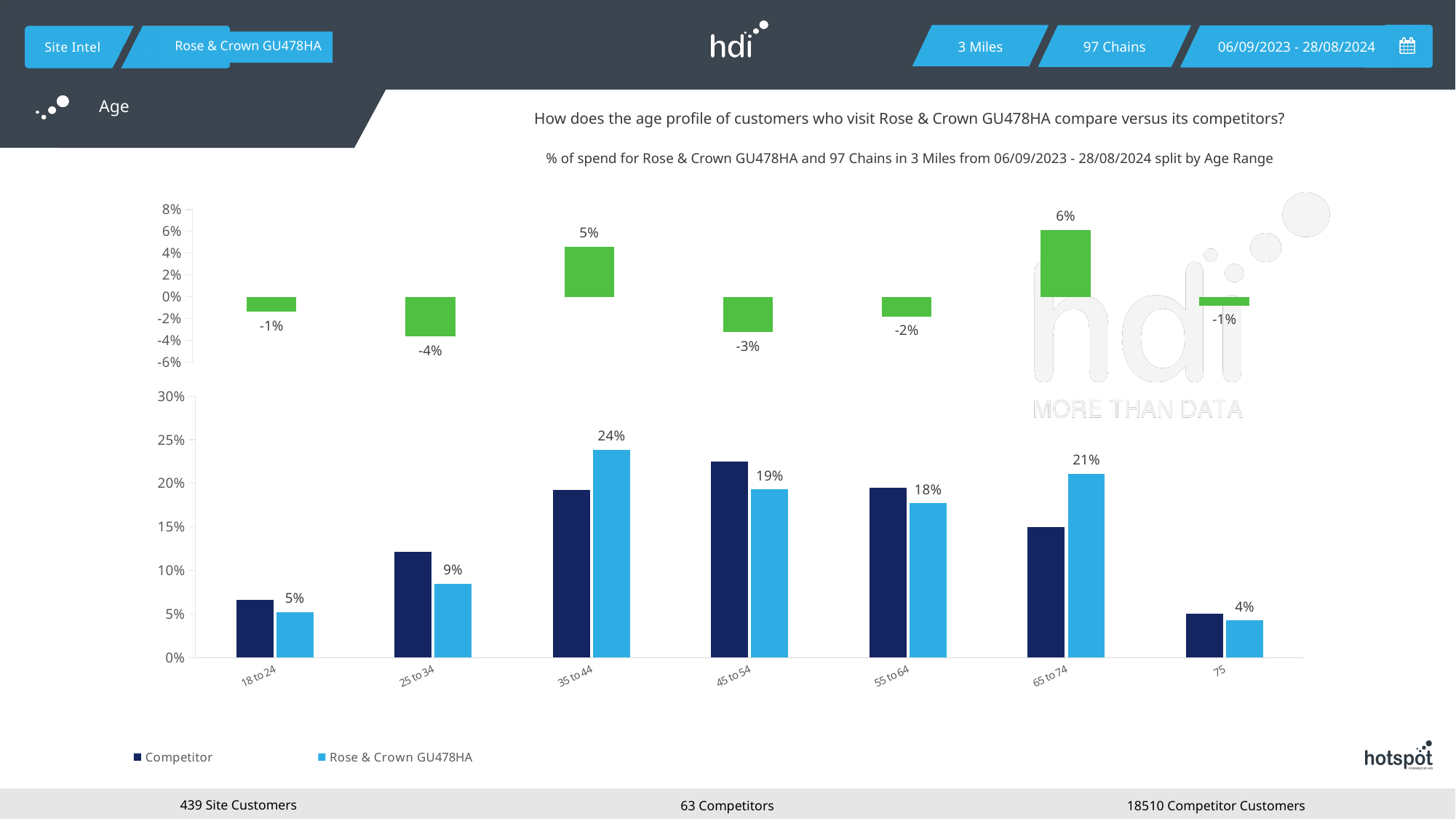
How many age ranges are shown on the x axis of the bottom chart? 7 In the bottom chart, is the Competitor value for 25 to 34 greater or less than 15%? less In the bottom chart, which is larger for the 65 to 74 age range: Competitor or Rose & Crown GU478HA? Rose & Crown GU478HA In the bottom chart, which age range has the lowest Rose & Crown GU478HA value? 75 In the top chart, what is the value for the 65 to 74 age range? 6% In the bottom chart, is the Competitor value for 45 to 54 greater or less than 20%? greater In the bottom chart, what is the value for Rose & Crown GU478HA in the 65 to 74 age range? 21% In the bottom chart, which age range has the highest Rose & Crown GU478HA value? 35 to 44 How many series does the legend of the bottom chart list? 2 In the bottom chart, what is the difference between the Rose & Crown GU478HA values for 35 to 44 and 25 to 34? 15% In the bottom chart, what is the value for Rose & Crown GU478HA in the 35 to 44 age range? 24% In the top chart, which age range has the lowest value? 25 to 34